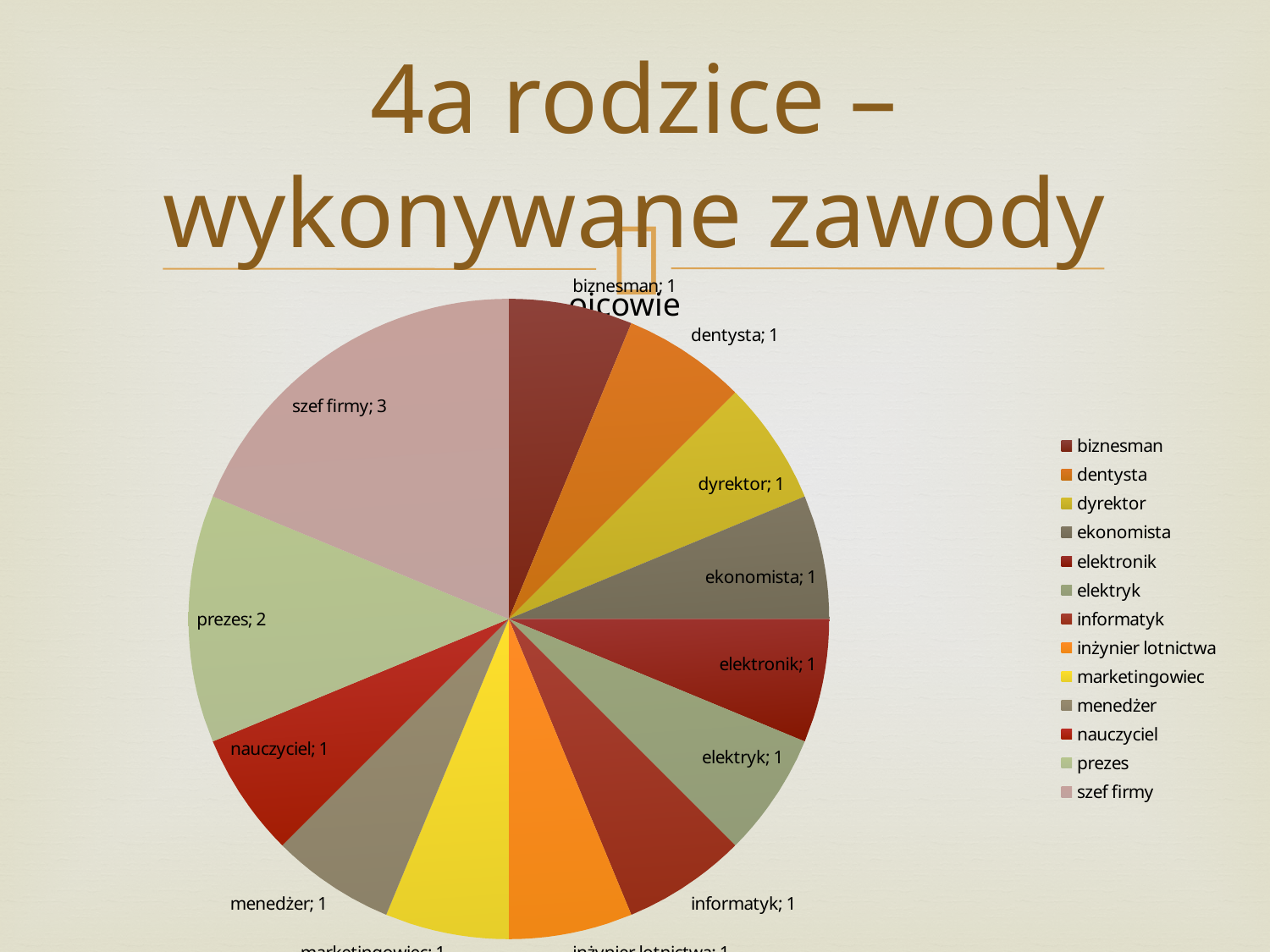
What is the value for ekonomista in the pie chart? 1 What is the difference between the values for szef firmy and dyrektor? 2 How many slices does the pie chart have? 13 What is the value for nauczyciel in the pie chart? 1 What is the value for szef firmy in the pie chart? 3 Which category has the largest slice in the pie chart? szef firmy Which is larger in the pie chart, prezes or dentysta? prezes Which is larger in the pie chart, szef firmy or prezes? szef firmy How many entries does the legend of the pie chart list? 13 What kind of chart is shown on the slide? pie chart What is the difference between the values for szef firmy and prezes? 1 What is the value for prezes in the pie chart? 2